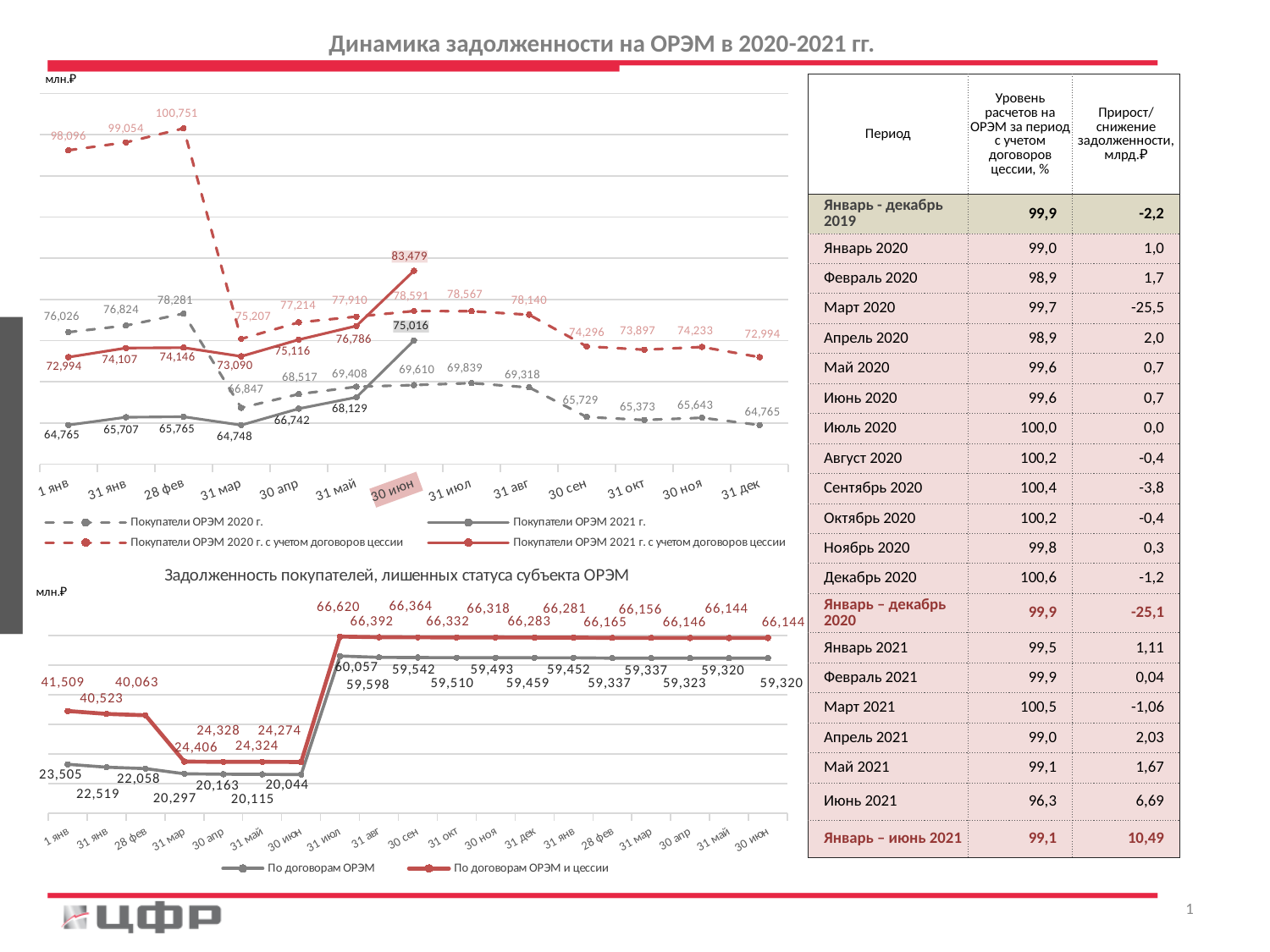
On the bottom chart (Задолженность покупателей, лишенных статуса субъекта ОРЭМ), what is the difference between По договорам ОРЭМ и цессии and По договорам ОРЭМ at 1 янв? 18,004 On the top chart, what is the value for Покупатели ОРЭМ 2021 г. с учетом договоров цессии at 30 июн? 83,479 On the top chart, at which date does Покупатели ОРЭМ 2021 г. have its lowest value? 31 мар On the top chart, at which date does Покупатели ОРЭМ 2020 г. с учетом договоров цессии reach its highest value? 28 фев On the top chart, what is the value for Покупатели ОРЭМ 2020 г. at 31 дек? 64,765 On the top chart, does Покупатели ОРЭМ 2021 г. rise or fall from 31 май to 30 июн? Rise How many series does the legend of the top chart list? 4 What kind of chart is the top chart? Line chart On the bottom chart (Задолженность покупателей, лишенных статуса субъекта ОРЭМ), which series is larger at 31 июл: По договорам ОРЭМ or По договорам ОРЭМ и цессии? По договорам ОРЭМ и цессии How many series does the legend of the bottom chart list? 2 On the bottom chart (Задолженность покупателей, лишенных статуса субъекта ОРЭМ), what is the value for По договорам ОРЭМ и цессии at 31 июл? 66,620 On the top chart, what is the difference between Покупатели ОРЭМ 2021 г. с учетом договоров цессии and Покупатели ОРЭМ 2021 г. at 30 июн? 8,463